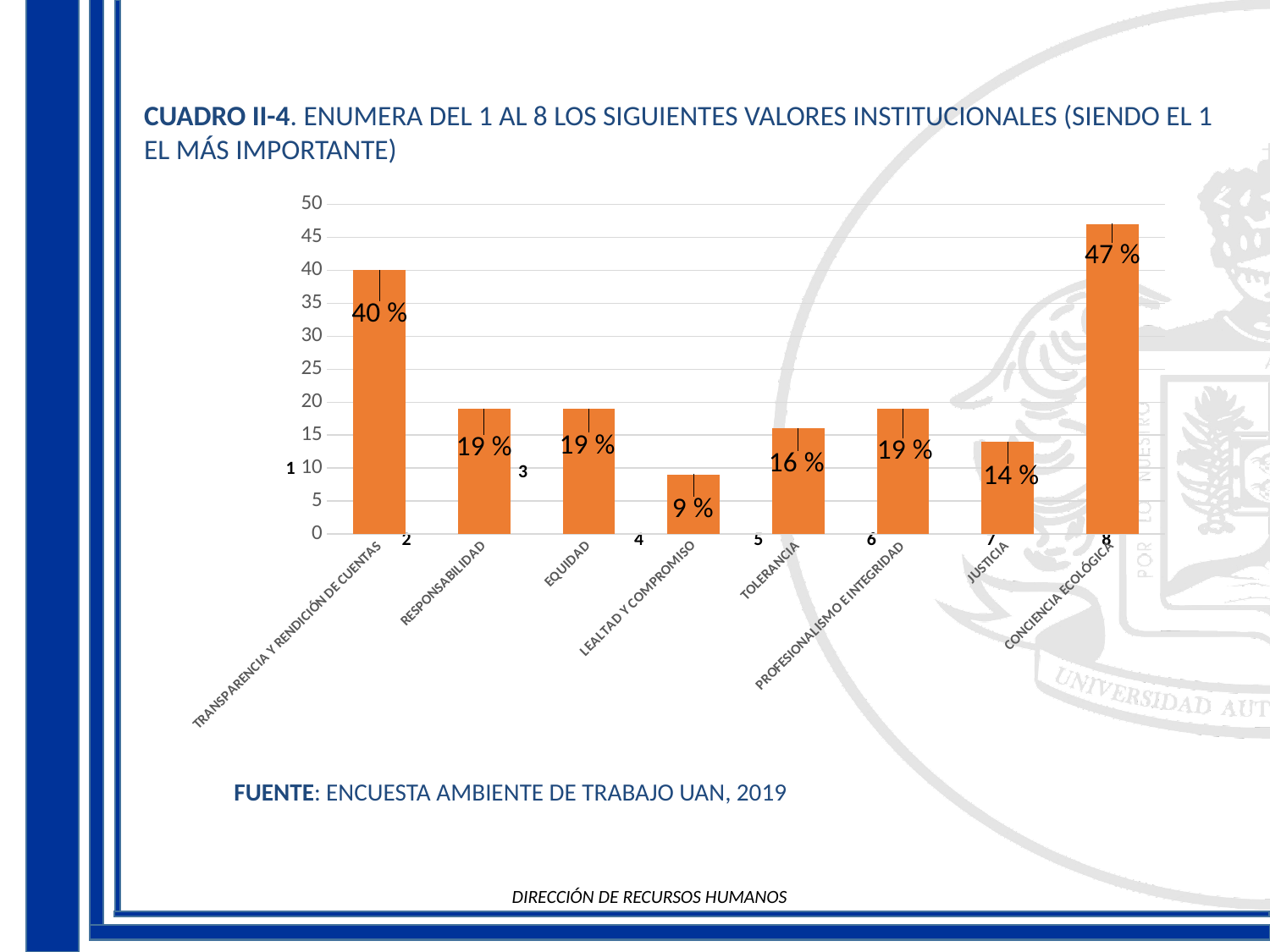
What is the value for JUSTICIA? 14 % Which is larger, the value for TOLERANCIA or the value for JUSTICIA? TOLERANCIA What is the value for TRANSPARENCIA Y RENDICIÓN DE CUENTAS? 40 % Which category has the highest value? CONCIENCIA ECOLÓGICA What is the value for LEALTAD Y COMPROMISO? 9 % Which category has the lowest value? LEALTAD Y COMPROMISO Is the value for TRANSPARENCIA Y RENDICIÓN DE CUENTAS greater or less than 35? greater How many categories are shown on the x axis? 8 What is the value for CONCIENCIA ECOLÓGICA? 47 % What is the source cited below the chart? ENCUESTA AMBIENTE DE TRABAJO UAN, 2019 What is the difference between the values for CONCIENCIA ECOLÓGICA and TRANSPARENCIA Y RENDICIÓN DE CUENTAS? 7 % What kind of chart is shown on the slide? bar chart